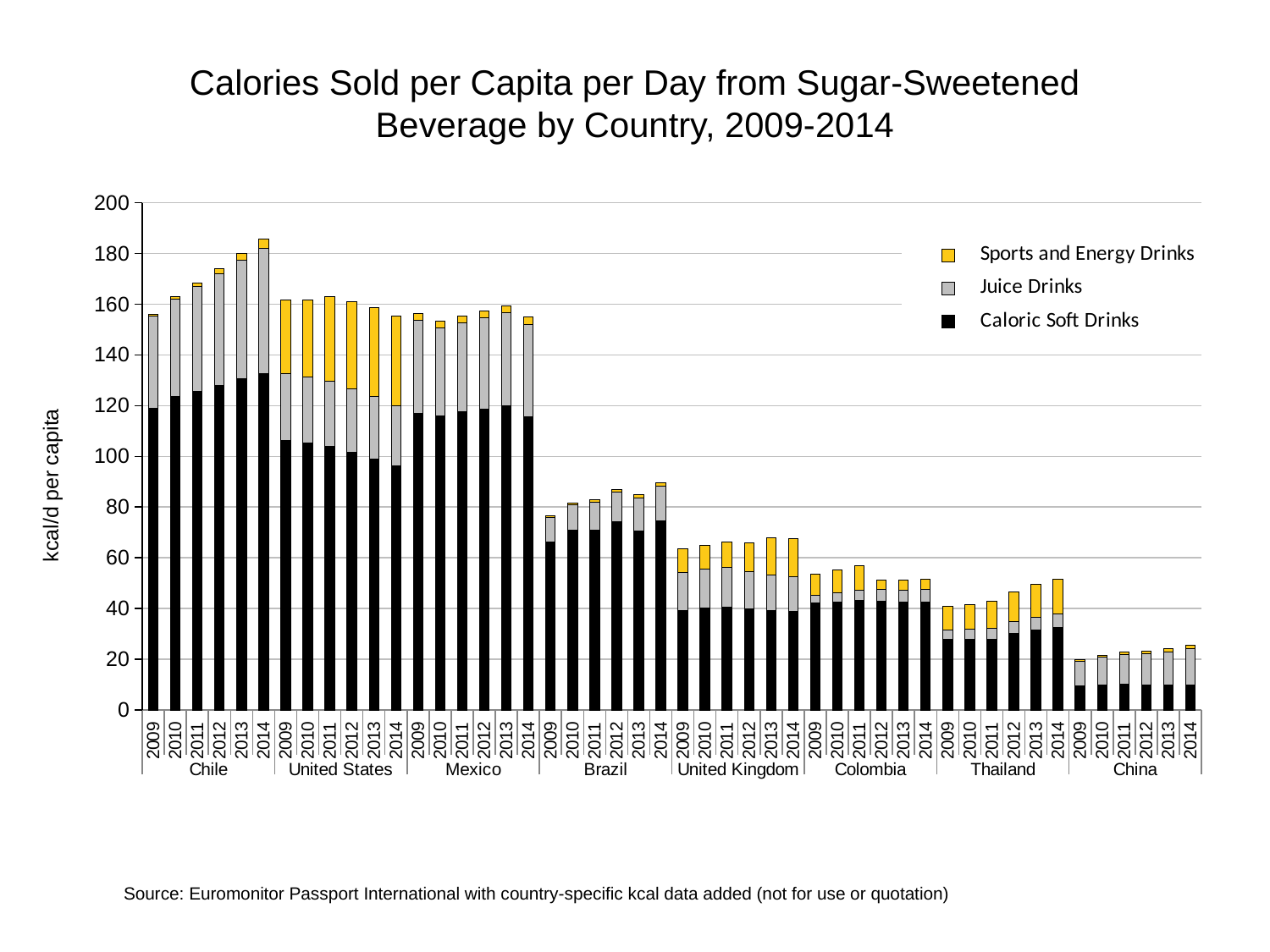
How many series does the legend list? 3 Which series is shown in yellow in the legend? Sports and Energy Drinks What kind of chart is shown on the slide? Stacked bar chart Which has the larger total in 2014, Chile or the United States? Chile Which country has the lowest total calories sold per capita per day across all years? China Is the total value for Mexico in 2009 greater or less than 160? less Is the total value for Chile in 2014 greater or less than 180? greater Do the total values for Chile rise or fall from 2009 to 2014? rise Is the total value for the United Kingdom in 2009 greater or less than 60? greater How many countries are shown along the x axis? 8 Which country and year has the highest total calories sold per capita per day? Chile, 2014